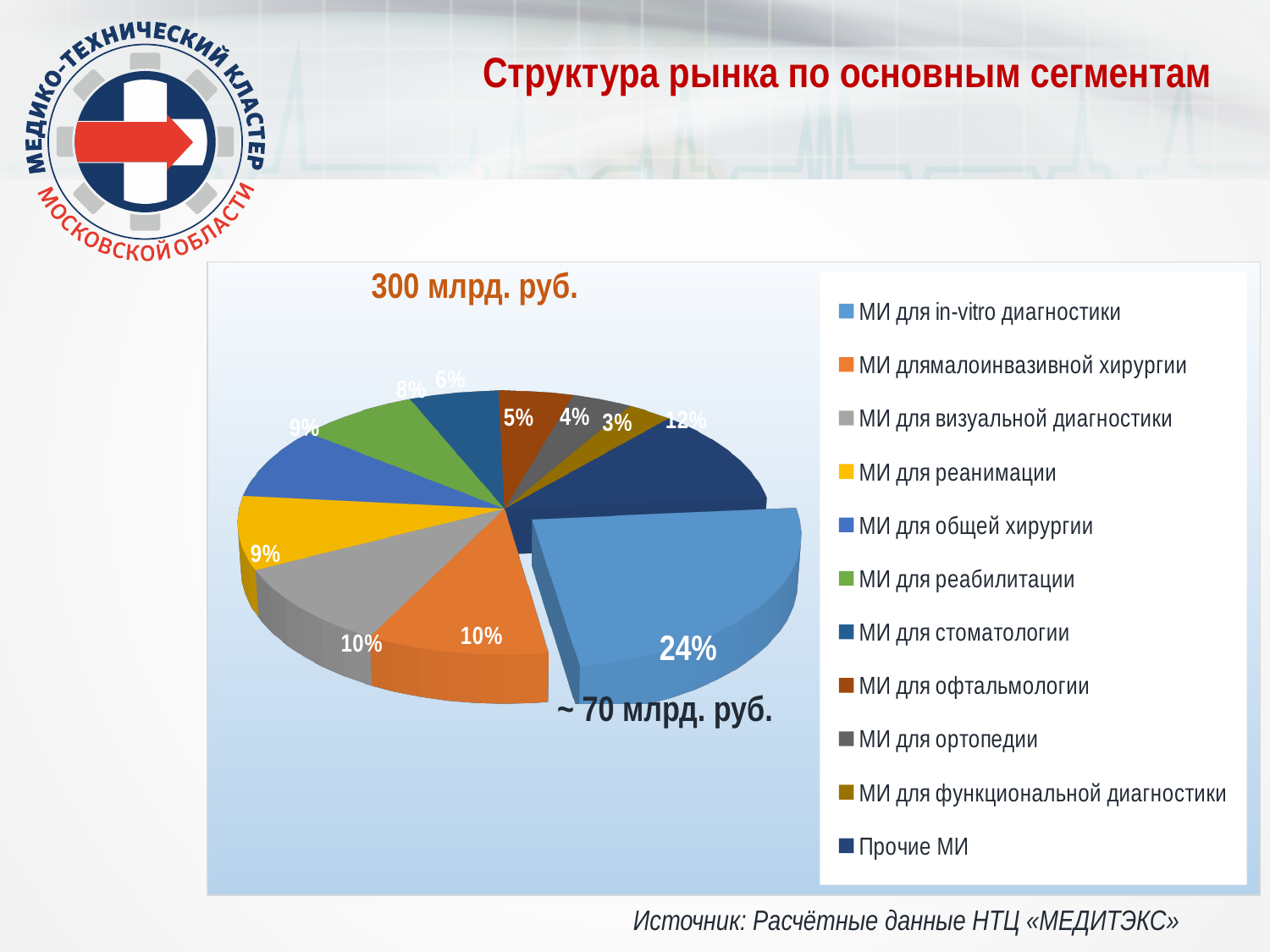
Which segment has the largest share of the market? МИ для in-vitro диагностики What share of the market is held by Прочие МИ? 12% What share of the market is held by МИ для реабилитации? 8% What kind of chart is shown on the slide? Pie chart What total market size is given in the chart title? 300 млрд. руб. How many segments does the legend list? 11 What is the difference in percentage points between the share of МИ для in-vitro диагностики and the share of Прочие МИ? 12 percentage points What share of the market is held by МИ для функциональной диагностики? 3% What share of the market is held by МИ для стоматологии? 6% Which has a larger share: МИ для офтальмологии or МИ для ортопедии? МИ для офтальмологии What share of the market is held by МИ для in-vitro диагностики? 24% Which segment has the smallest share of the market? МИ для функциональной диагностики